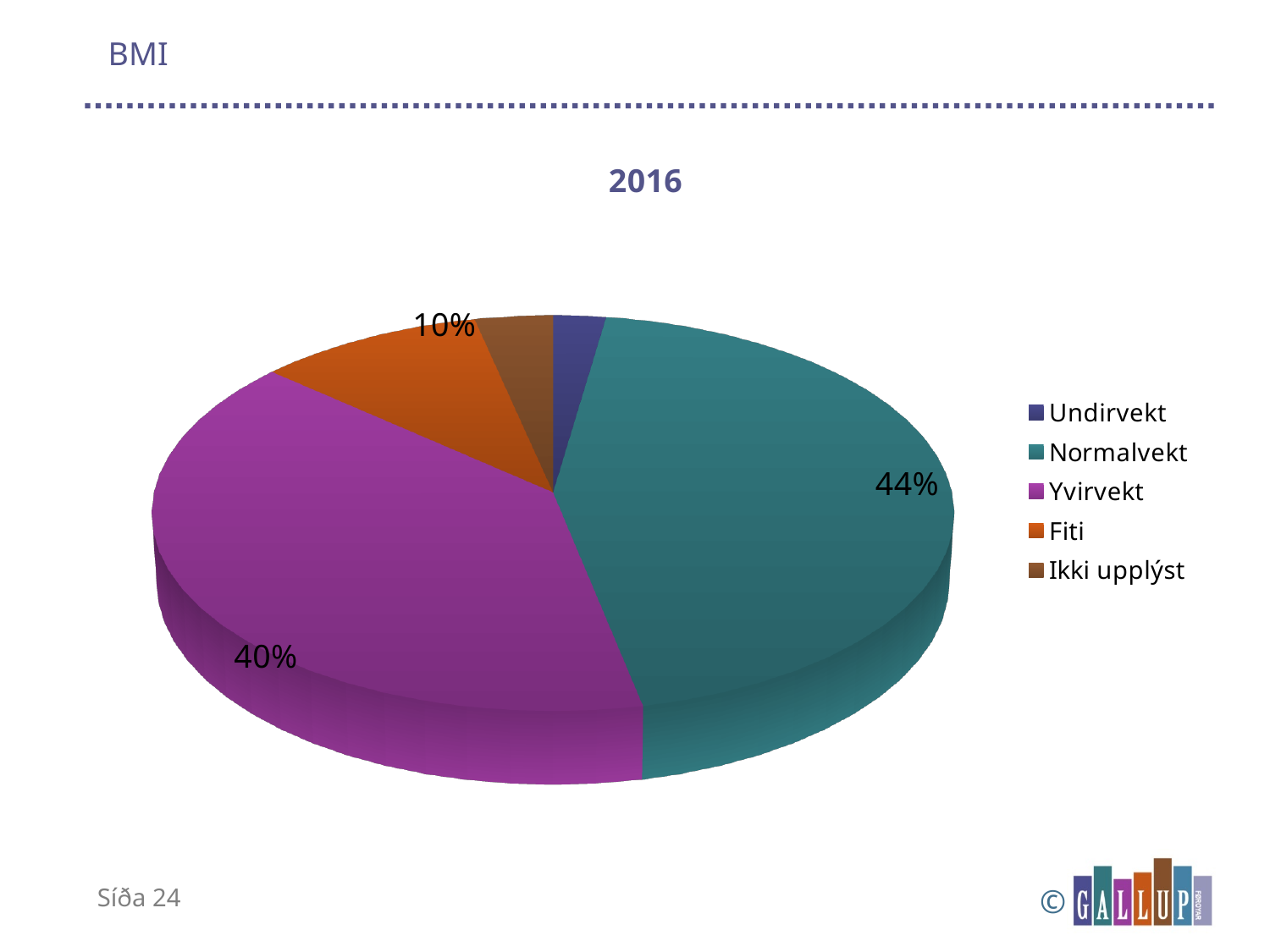
What is the combined percentage of the Normalvekt, Yvirvekt and Fiti slices? 94% What is the difference in percentage points between the Normalvekt and Yvirvekt slices? 4 percentage points Which category has the largest slice of the pie? Normalvekt What kind of chart is shown on the slide? Pie chart What percentage is shown for the Fiti slice? 10% Which slice is larger, Normalvekt or Yvirvekt? Normalvekt Which slice is larger, Fiti or Yvirvekt? Yvirvekt How many categories does the pie chart show? 5 What is the title of the chart? 2016 What percentage of the pie is labelled for Normalvekt? 44% Which legend entry is shown in orange? Fiti What percentage is shown for the Yvirvekt slice? 40%